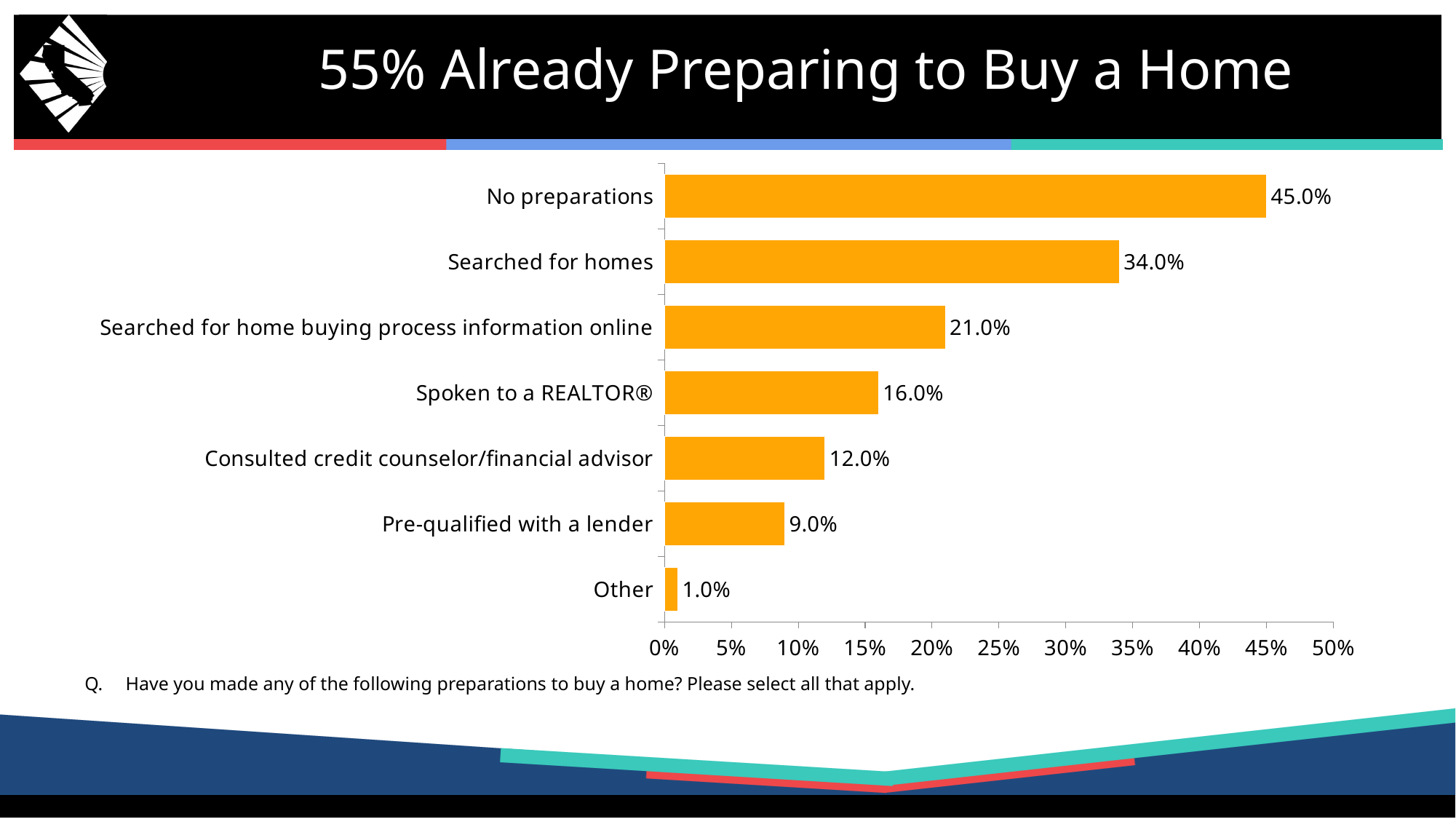
Which category has the highest value? No preparations What is the difference between 'Searched for homes' and 'Searched for home buying process information online'? 13.0% What colour are the bars in the chart? Orange Which category has the lowest value? Other Which is larger: 'Consulted credit counselor/financial advisor' or 'Pre-qualified with a lender'? Consulted credit counselor/financial advisor What is the value for 'Spoken to a REALTOR®'? 16.0% What percentage of respondents reported 'No preparations'? 45.0% What percentage had 'Pre-qualified with a lender'? 9.0% How many categories are shown in the chart? 7 What is the title of the slide? 55% Already Preparing to Buy a Home Is the value for 'Searched for homes' greater or less than 30%? greater What kind of chart is shown on the slide? Bar chart